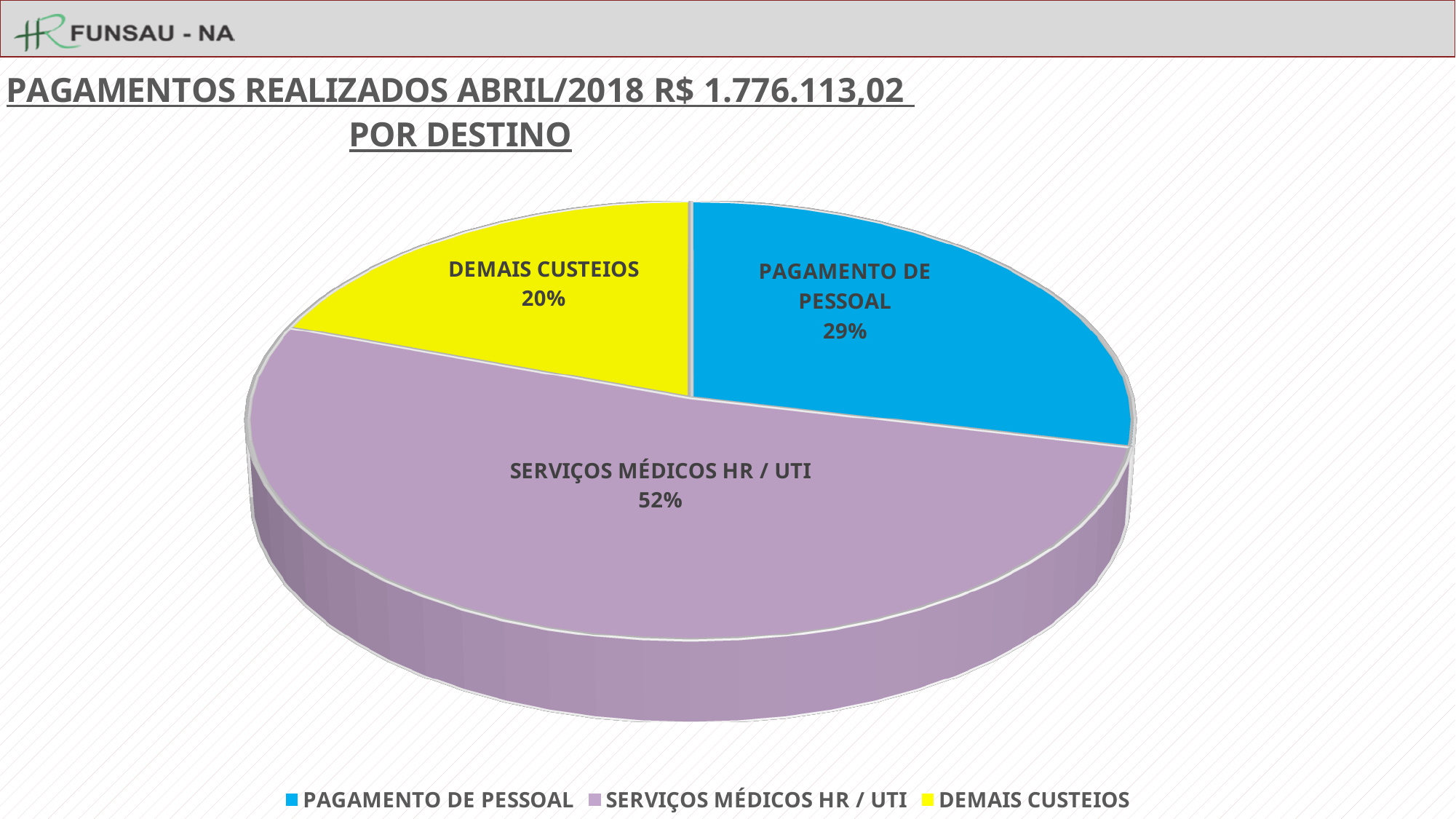
What share of the pie does SERVIÇOS MÉDICOS HR / UTI represent? 52% How many slices does the pie chart have? 3 What kind of chart is shown on the slide? Pie chart Which category has the smallest slice of the pie? DEMAIS CUSTEIOS What share of the pie does DEMAIS CUSTEIOS represent? 20% What total amount is stated in the slide title for the payments made in April 2018? R$ 1.776.113,02 What colour is the slice for DEMAIS CUSTEIOS? Yellow What is the difference in percentage points between SERVIÇOS MÉDICOS HR / UTI and PAGAMENTO DE PESSOAL? 23 percentage points Which is larger, the share for PAGAMENTO DE PESSOAL or the share for DEMAIS CUSTEIOS? PAGAMENTO DE PESSOAL Which category has the largest slice of the pie? SERVIÇOS MÉDICOS HR / UTI What is the difference in percentage points between PAGAMENTO DE PESSOAL and DEMAIS CUSTEIOS? 9 percentage points What share of the pie does PAGAMENTO DE PESSOAL represent? 29%